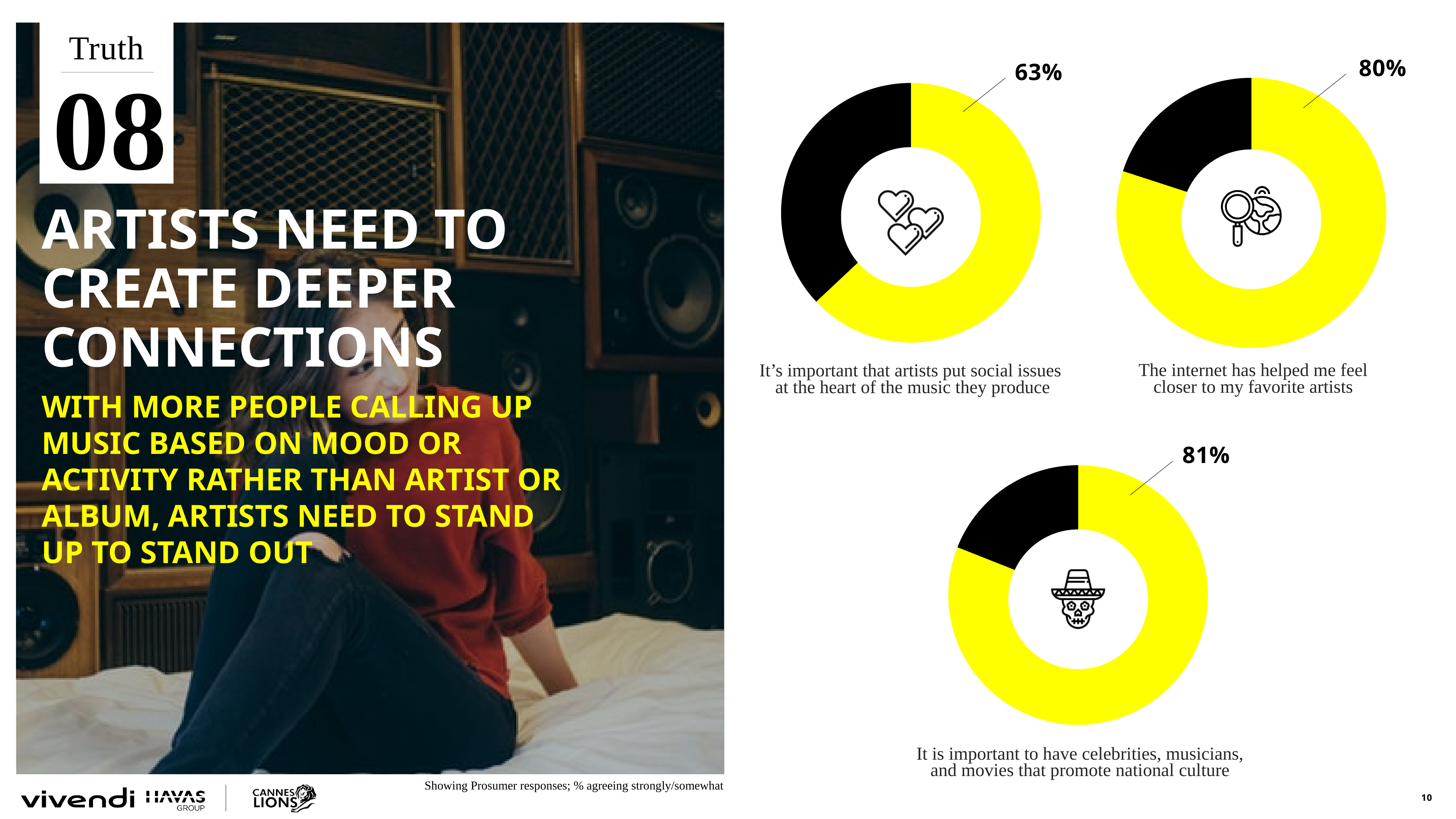
What kind of chart is used to show the percentages on the right side of the slide? Donut (pie) chart In the bottom donut chart, what percentage agree that it is important to have celebrities, musicians, and movies that promote national culture? 81% How many donut charts are shown on the slide? 3 What colour is used for the highlighted (agreeing) portion of each donut chart? Yellow Across the three donut charts on the slide, which statement has the lowest percentage of agreement? It's important that artists put social issues at the heart of the music they produce In the top-left donut chart, what share of the ring is not coloured yellow (the black portion)? 37% What is the difference in percentage points between the top-right chart (internet helped me feel closer to favorite artists) and the top-left chart (artists put social issues at the heart of their music)? 17 In the top-right donut chart, what percentage agree that the internet has helped them feel closer to their favorite artists? 80% What is the difference in percentage points between the bottom chart (promote national culture) and the top-right chart (internet helped me feel closer to favorite artists)? 1 Across the three donut charts on the slide, which statement has the highest percentage of agreement? It is important to have celebrities, musicians, and movies that promote national culture In the top-left donut chart, what percentage agree that it's important that artists put social issues at the heart of the music they produce? 63% Which is larger: the percentage in the top-left chart about artists putting social issues at the heart of their music, or the percentage in the top-right chart about the internet helping people feel closer to favorite artists? The internet has helped me feel closer to my favorite artists